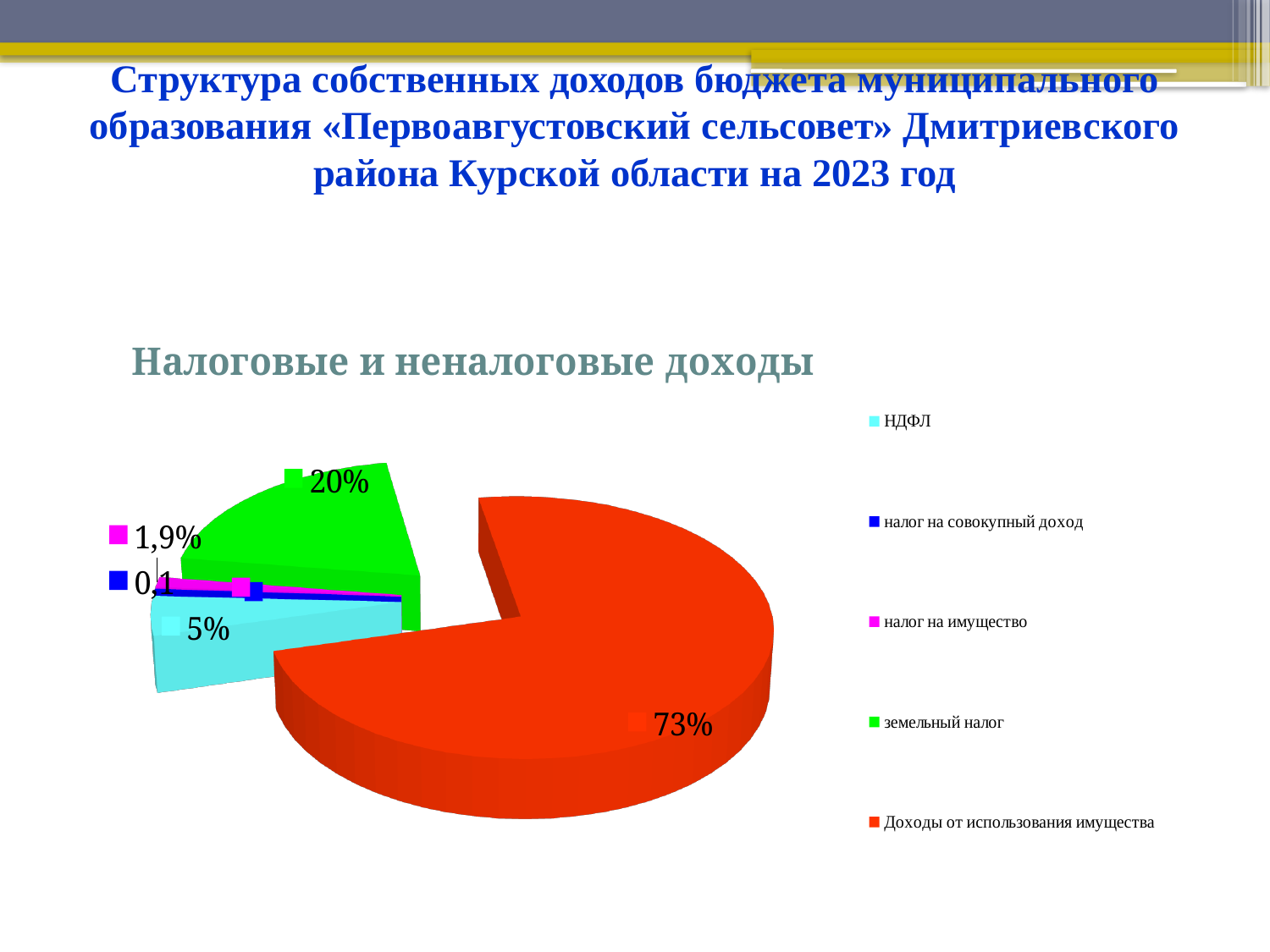
What kind of chart is shown on the slide? pie chart What value is labelled for налог на совокупный доход? 0,1 How many categories does the legend of the pie chart list? 5 Which category has the smallest slice of the pie? налог на совокупный доход What value is labelled for налог на имущество? 1,9% Which category has the largest slice of the pie? Доходы от использования имущества Which is larger, the slice for земельный налог or the slice for НДФЛ? земельный налог What is the title of the chart? Налоговые и неналоговые доходы What is the difference between the share for Доходы от использования имущества and the share for земельный налог? 53% What share of the pie is labelled for земельный налог? 20% What share of the pie is labelled for НДФЛ? 5% What share of the pie is labelled for Доходы от использования имущества? 73%